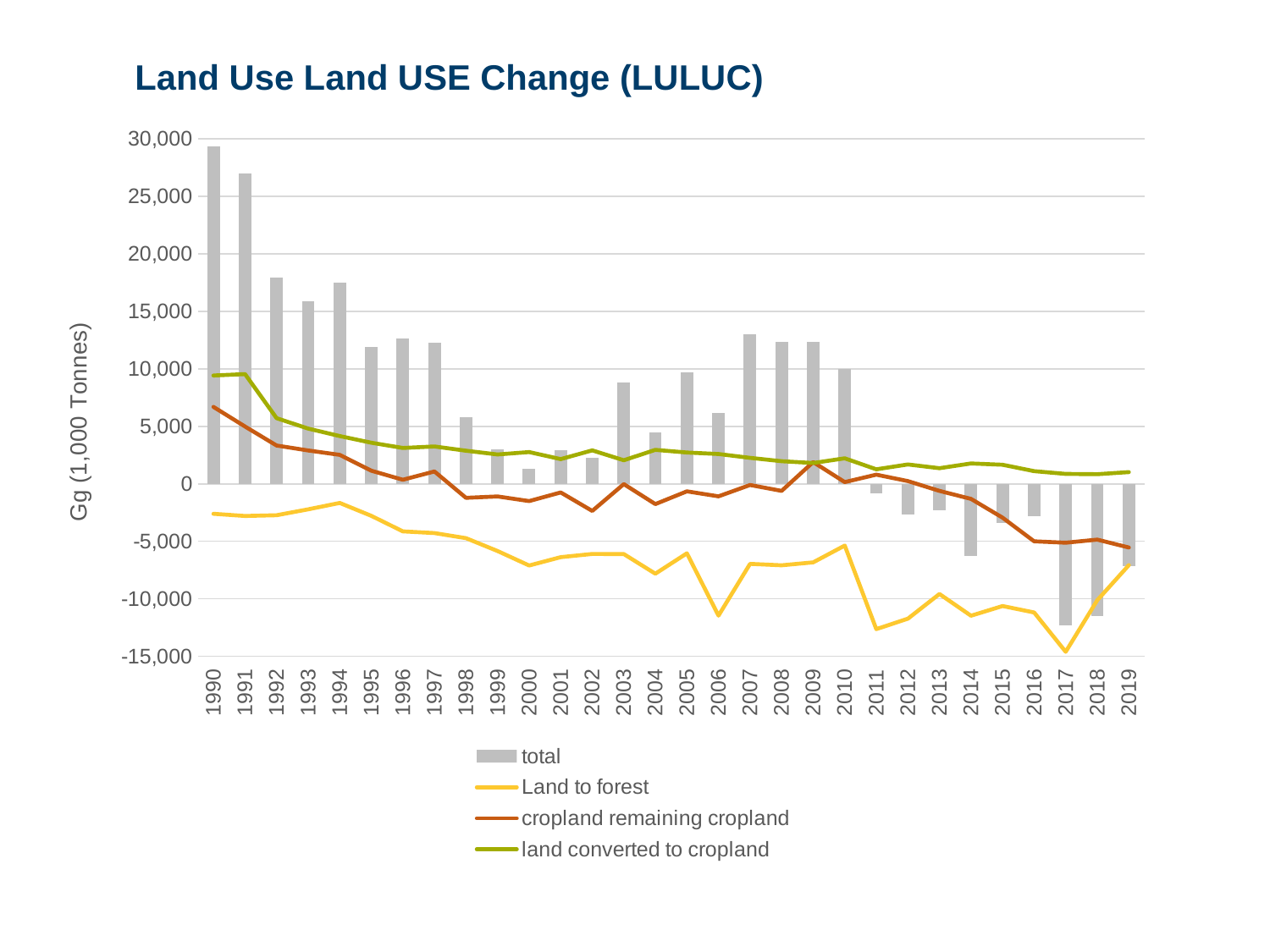
Is the 'total' value for 2000 greater or less than 5,000? less Overall, do the 'total' bars rise or fall from 1990 to 2019? fall How many years are shown along the x axis? 30 In which year is the 'total' bar highest? 1990 How many series does the legend list? 4 What is the label on the y axis? Gg (1,000 Tonnes) In which year does the 'Land to forest' line reach its lowest value? 2017 What kind of chart is shown on the slide? A combined bar and line chart Is the 'Land to forest' value for 2006 greater or less than -10,000? less Is the 'total' value for 1990 greater or less than 25,000? greater Which year has the larger 'total' bar, 1990 or 1991? 1990